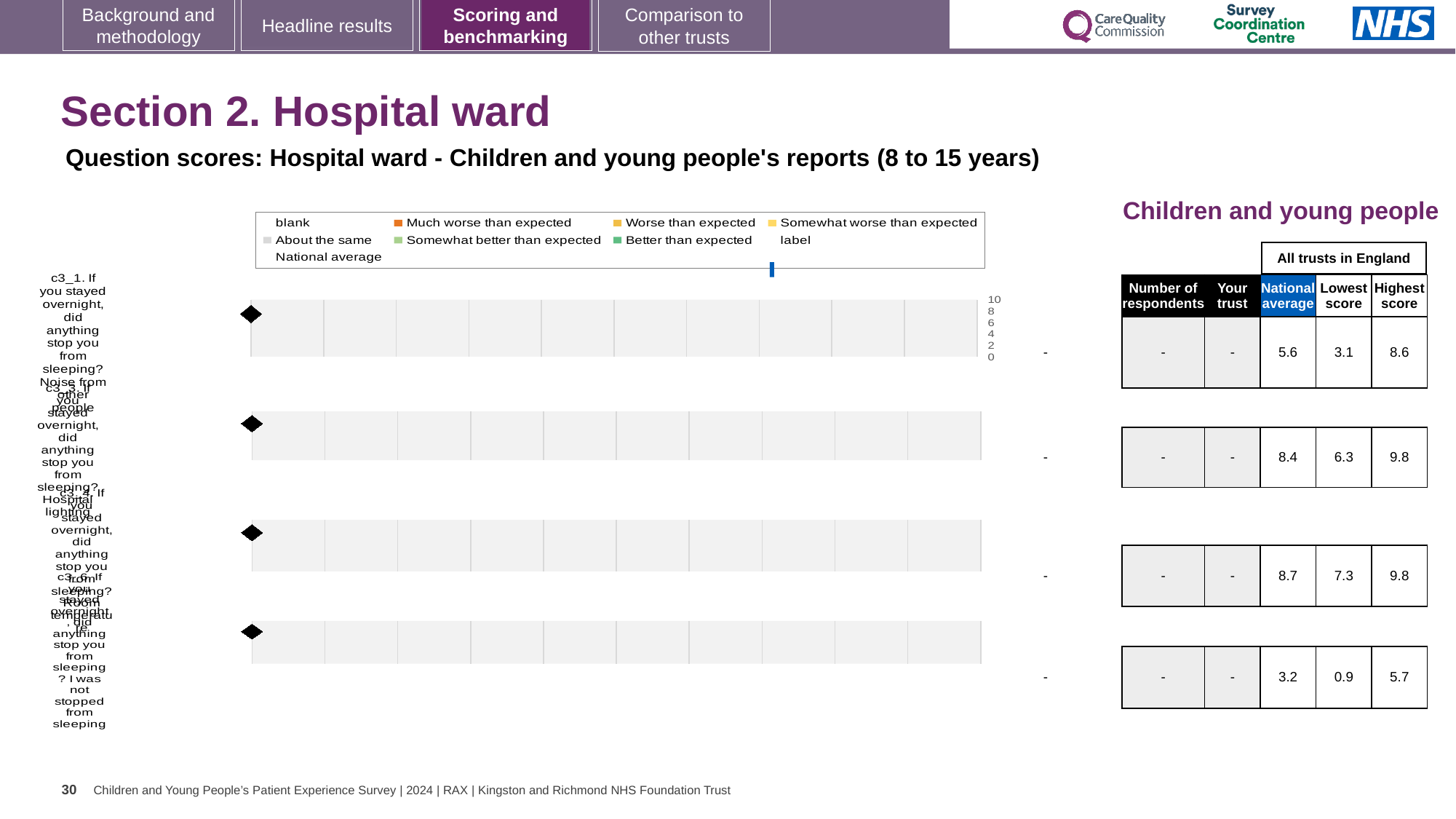
In the table beside the chart, what is the highest score for c3_3 (hospital lighting)? 9.8 What kind of chart is shown on the slide? bar chart What is the highest value shown on the chart's axis? 10 In the table beside the chart, what is the lowest score for c3_6 (I was not stopped from sleeping)? 0.9 In the table beside the chart, which question row has the highest national average? c3_4 (room temperature) In the table beside the chart, what is the national average for c3_1 (noise from other people)? 5.6 In the table beside the chart, what is the difference between the highest and lowest score for c3_1 (noise from other people)? 5.5 In the table beside the chart, is the national average for c3_3 (hospital lighting) larger or smaller than that for c3_4 (room temperature)? smaller How many entries does the chart legend list? 9 Which legend entry is shown with an orange marker? Much worse than expected How many question rows (categories) does the chart show? 4 In the table beside the chart, which question row has the lowest national average? c3_6 (I was not stopped from sleeping)